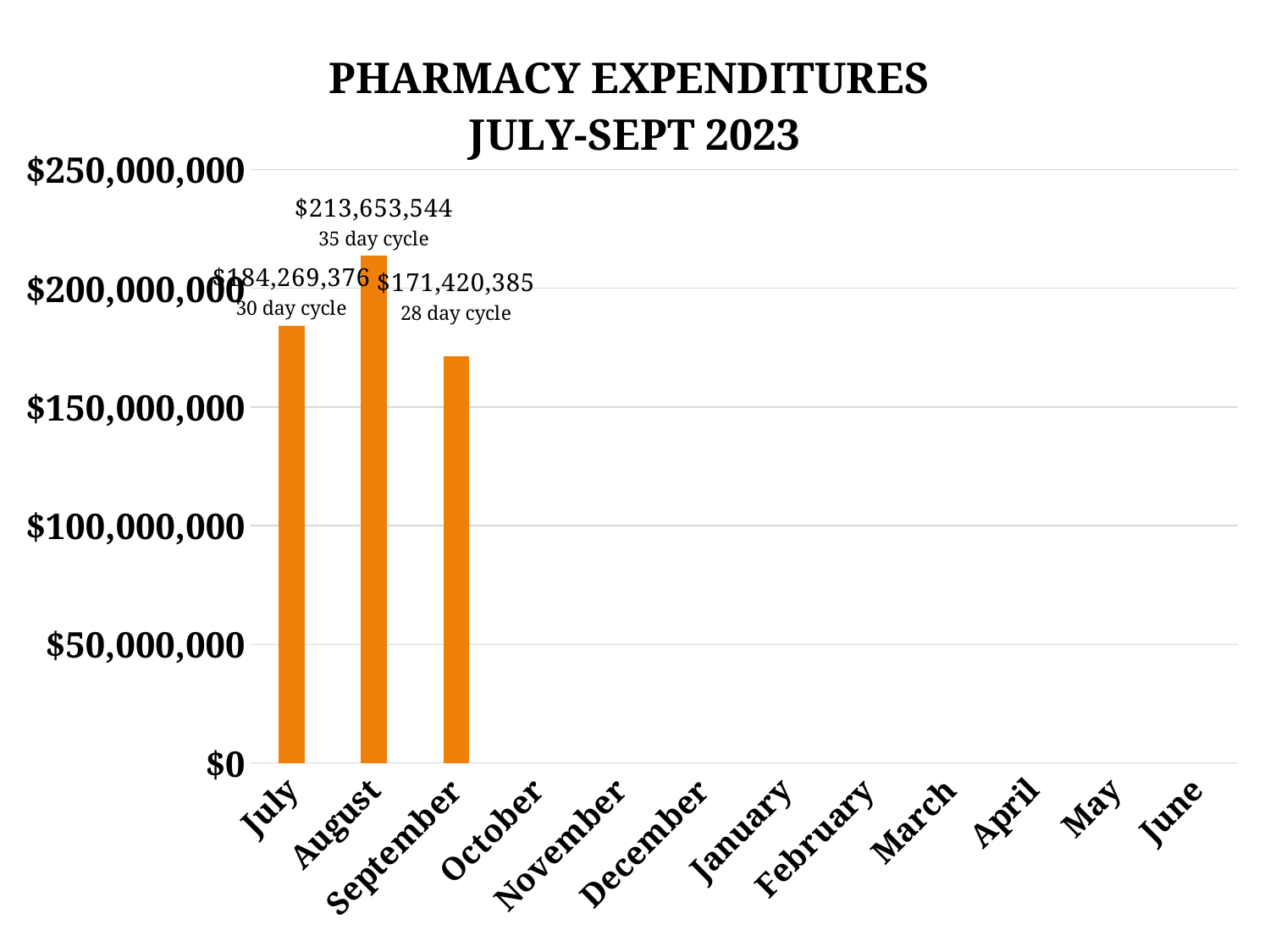
Is the value for August greater or less than $200,000,000? greater What kind of chart is shown on the slide? Bar chart Which of the months with a plotted bar has the lowest pharmacy expenditure? September How many months have a bar plotted on the chart? 3 Which is larger, the expenditure for July or for September? July What is the pharmacy expenditure for August? $213,653,544 How many days is the billing cycle noted for August? 35 day cycle What is the pharmacy expenditure for July? $184,269,376 What is the difference between the July and September expenditures? $12,848,991 Which month has the highest pharmacy expenditure? August What is the pharmacy expenditure for September? $171,420,385 What is the difference between the August and July expenditures? $29,384,168